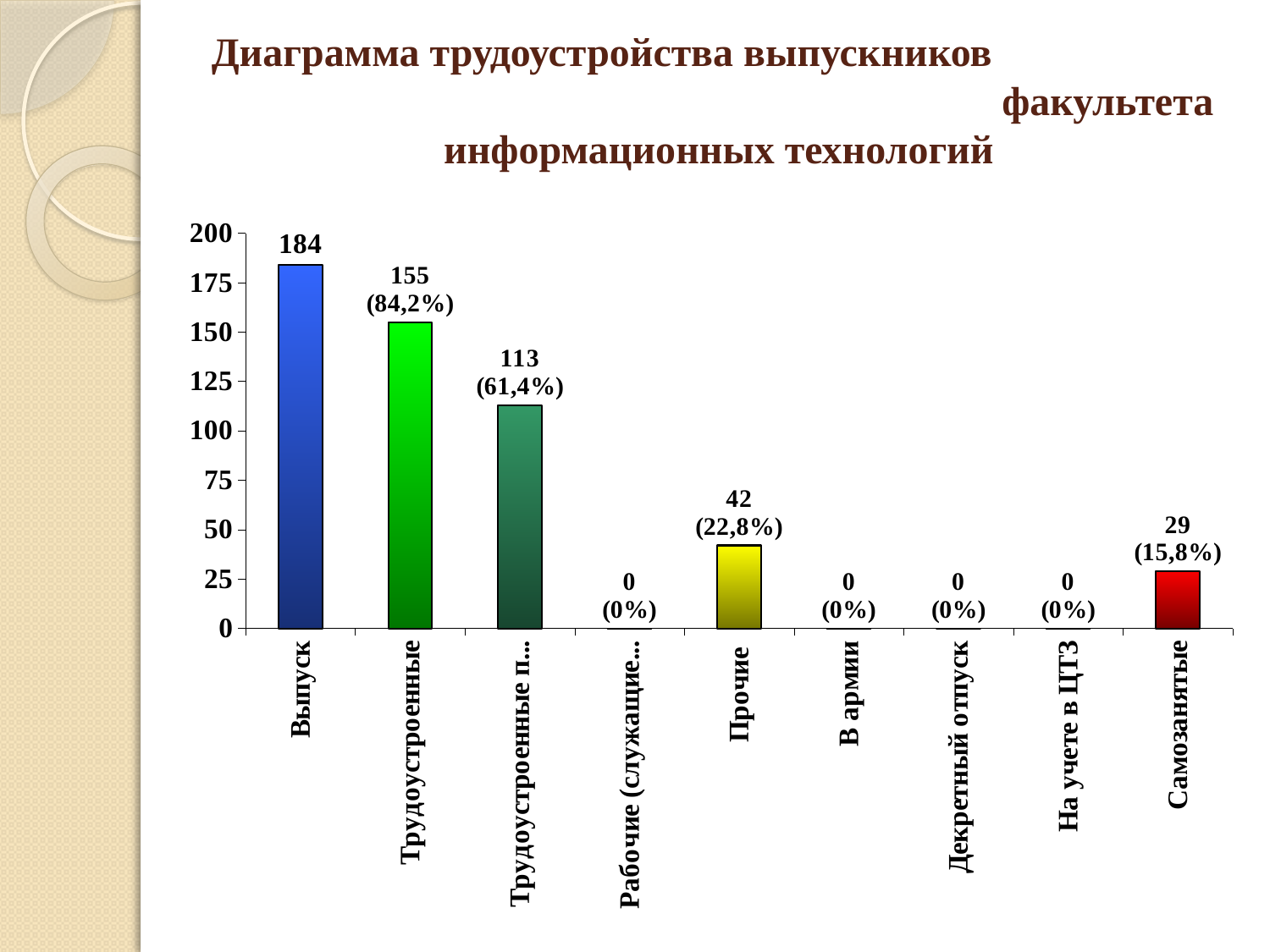
What colour is the bar for Самозанятые? Red What percentage is shown for Прочие? 22,8% What percentage is shown for Самозанятые? 15,8% Which is larger, the value for Прочие or the value for Самозанятые? Прочие What is the value for Самозанятые? 29 How many categories are shown on the x axis? 9 Which category has the highest value? Выпуск What is the value for Трудоустроенные? 155 What is the value for В армии? 0 What is the value for Выпуск? 184 What is the difference between the values for Выпуск and Трудоустроенные? 29 What kind of chart is shown on the slide? Bar chart